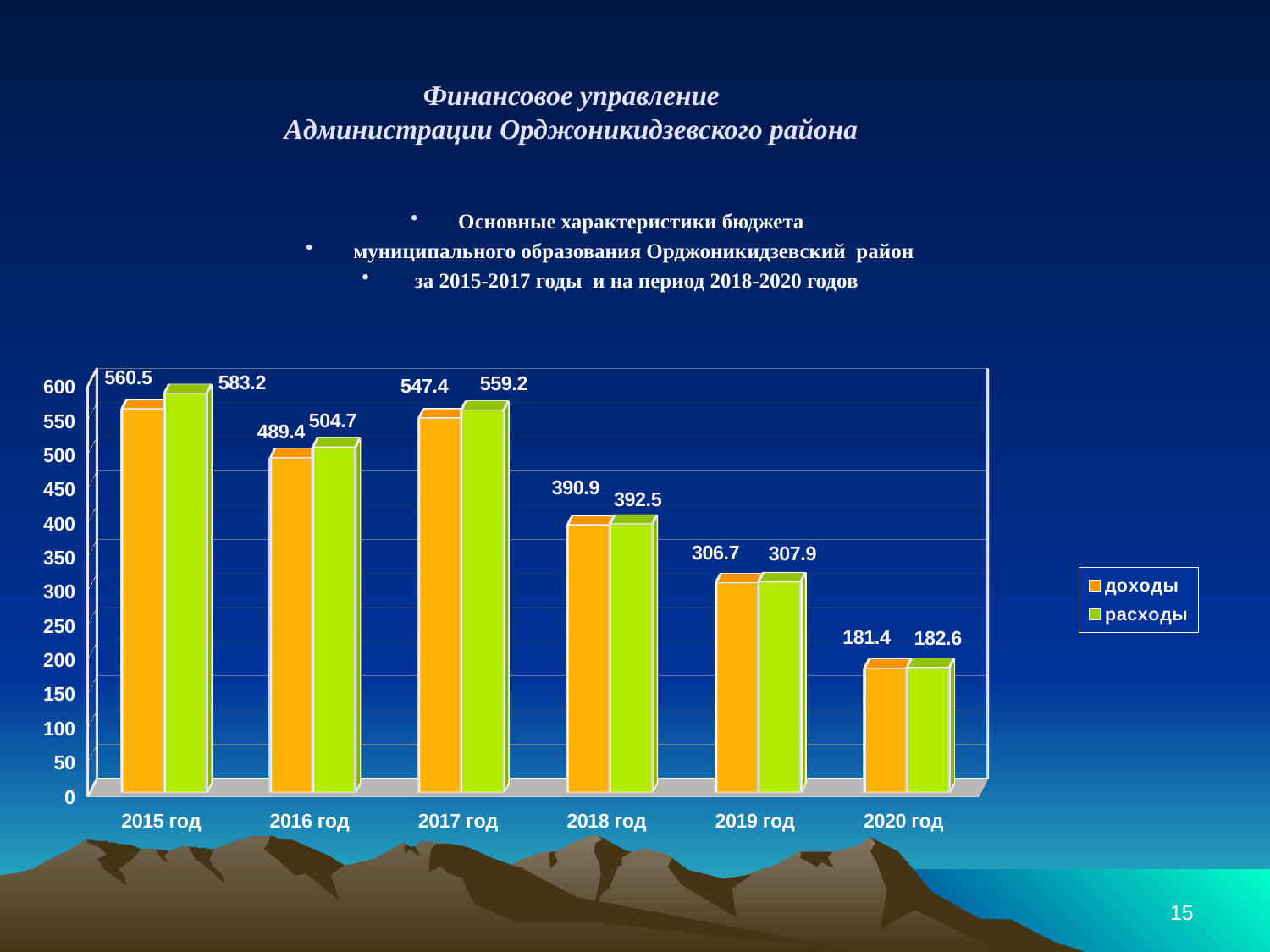
How many years are shown on the x axis? 6 Which year has the highest value of расходы? 2015 год Is the value of расходы for 2019 год greater or less than 350? less What kind of chart is shown on the slide? bar chart What is the value of доходы for 2015 год? 560.5 What is the difference between расходы and доходы for 2015 год? 22.7 Which is larger: доходы for 2016 год or доходы for 2017 год? доходы for 2017 год Which year has the lowest value of доходы? 2020 год How many series does the legend list? 2 What is the difference between доходы for 2017 год and доходы for 2018 год? 156.5 What is the value of доходы for 2020 год? 181.4 What is the value of расходы for 2018 год? 392.5